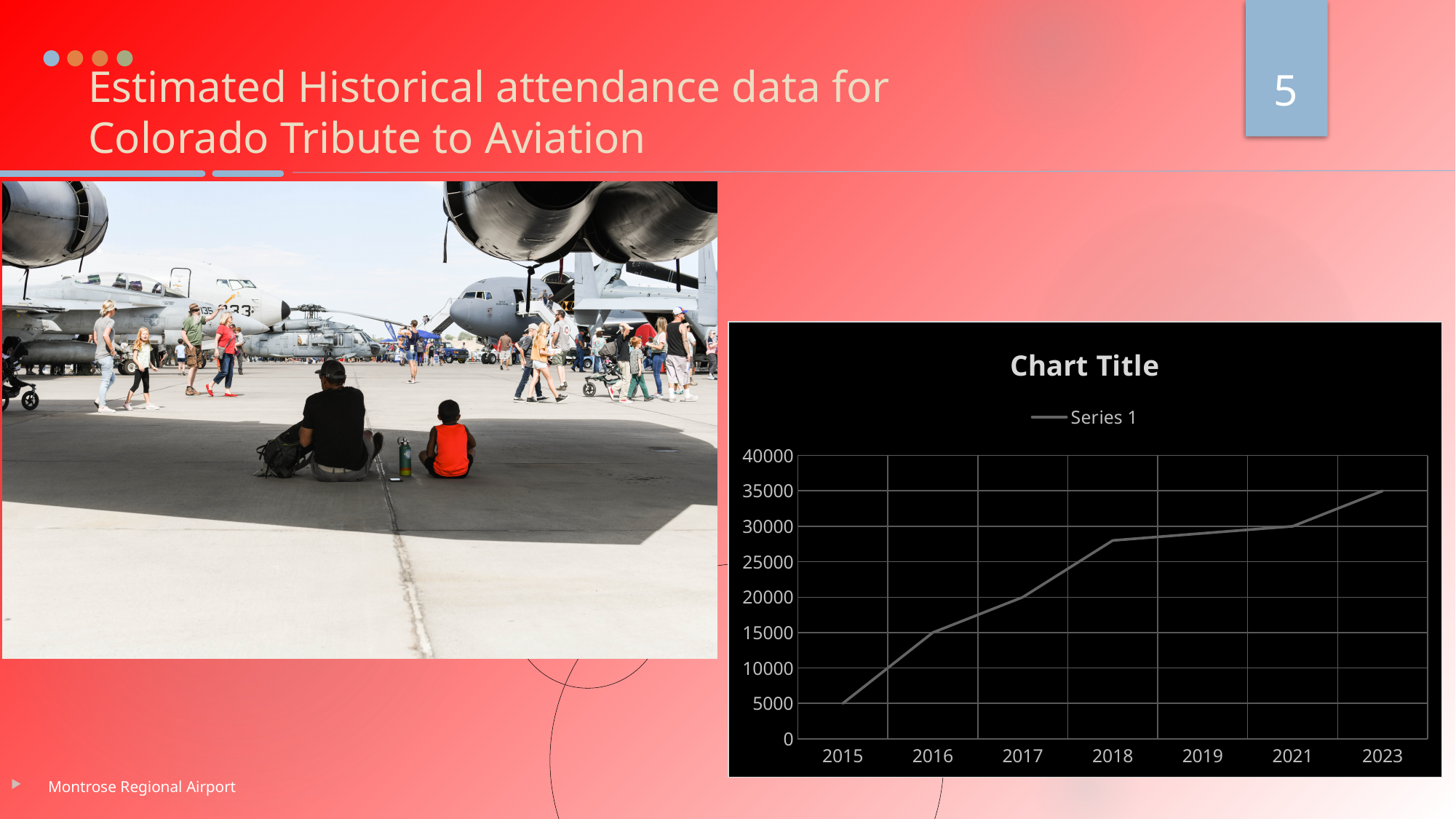
Which is larger, the value for 2016 or the value for 2021? 2021 What is the title shown on the chart? Chart Title Which year has the highest value in the chart? 2023 Is the value for 2017 greater or less than 25000? less How many years are shown on the x axis of the chart? 7 What is the name of the series shown in the chart legend? Series 1 How many series does the chart legend list? 1 Is the value for 2018 greater or less than 25000? greater Which year has the lowest value in the chart? 2015 What kind of chart is shown on the slide? line chart Do the values rise or fall from 2015 to 2023 in the chart? rise